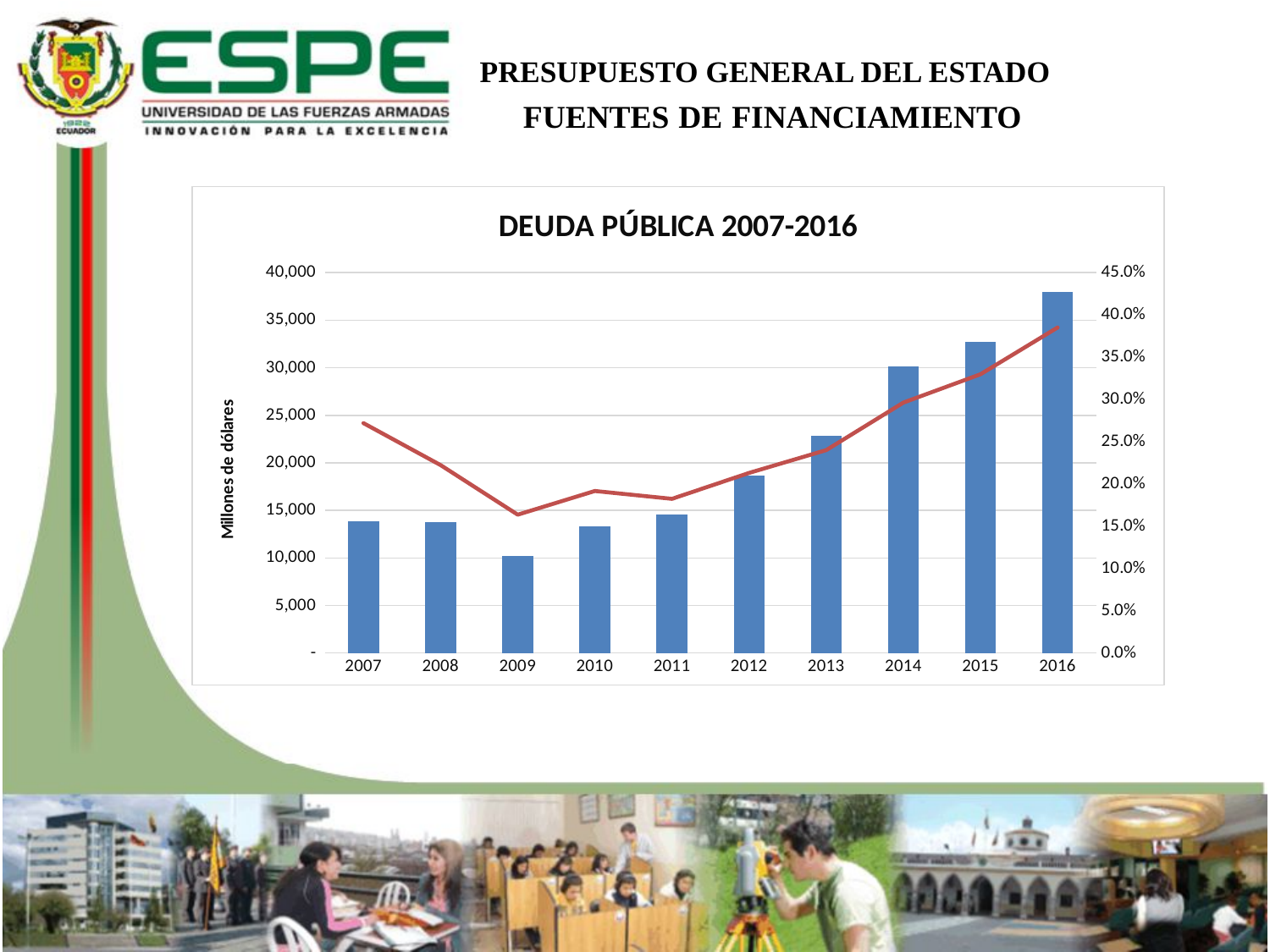
How many years are plotted along the x axis of the chart? 10 What is the title of the chart on the slide? DEUDA PÚBLICA 2007-2016 Is the red line value for 2009 greater or less than 20.0%? less Is the bar for 2016 greater or less than 35,000? greater Which year has the tallest bar in the chart? 2016 Is the red line value for 2016 greater or less than 35.0%? greater Do the bars rise or fall from 2011 to 2016? rise Which year has the shortest bar in the chart? 2009 Which year has the taller bar, 2013 or 2014? 2014 What kind of chart is shown on the slide? A bar chart combined with a line